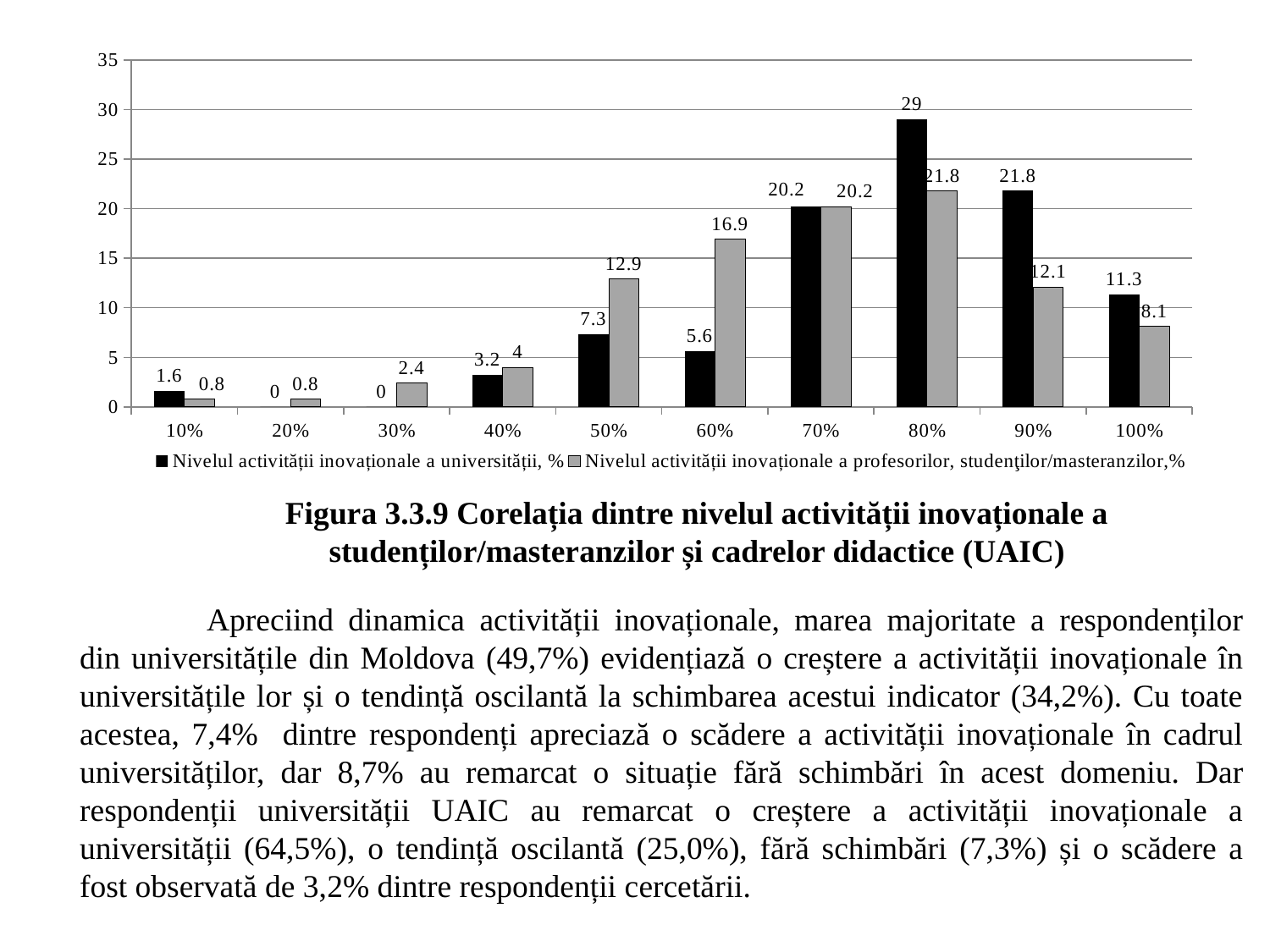
What is the value of 'Nivelul activității inovaționale a universității, %' at 50%? 7.3 What is the value of 'Nivelul activității inovaționale a profesorilor, studenţilor/masteranzilor,%' at 60%? 16.9 What type of chart is shown on the slide? bar chart At which category is 'Nivelul activității inovaționale a profesorilor, studenţilor/masteranzilor,%' highest? 80% What is the value of 'Nivelul activității inovaționale a universității, %' at 80%? 29 What is the difference between the two series at 80%? 7.2 How many series does the legend list? 2 Which series has the larger value at 60%? Nivelul activității inovaționale a profesorilor, studenţilor/masteranzilor,% What is the difference between the values of 'Nivelul activității inovaționale a universității, %' at 90% and 100%? 10.5 At which category is 'Nivelul activității inovaționale a universității, %' highest? 80% Which series has the larger value at 90%? Nivelul activității inovaționale a universității, % How many categories are shown on the x axis? 10